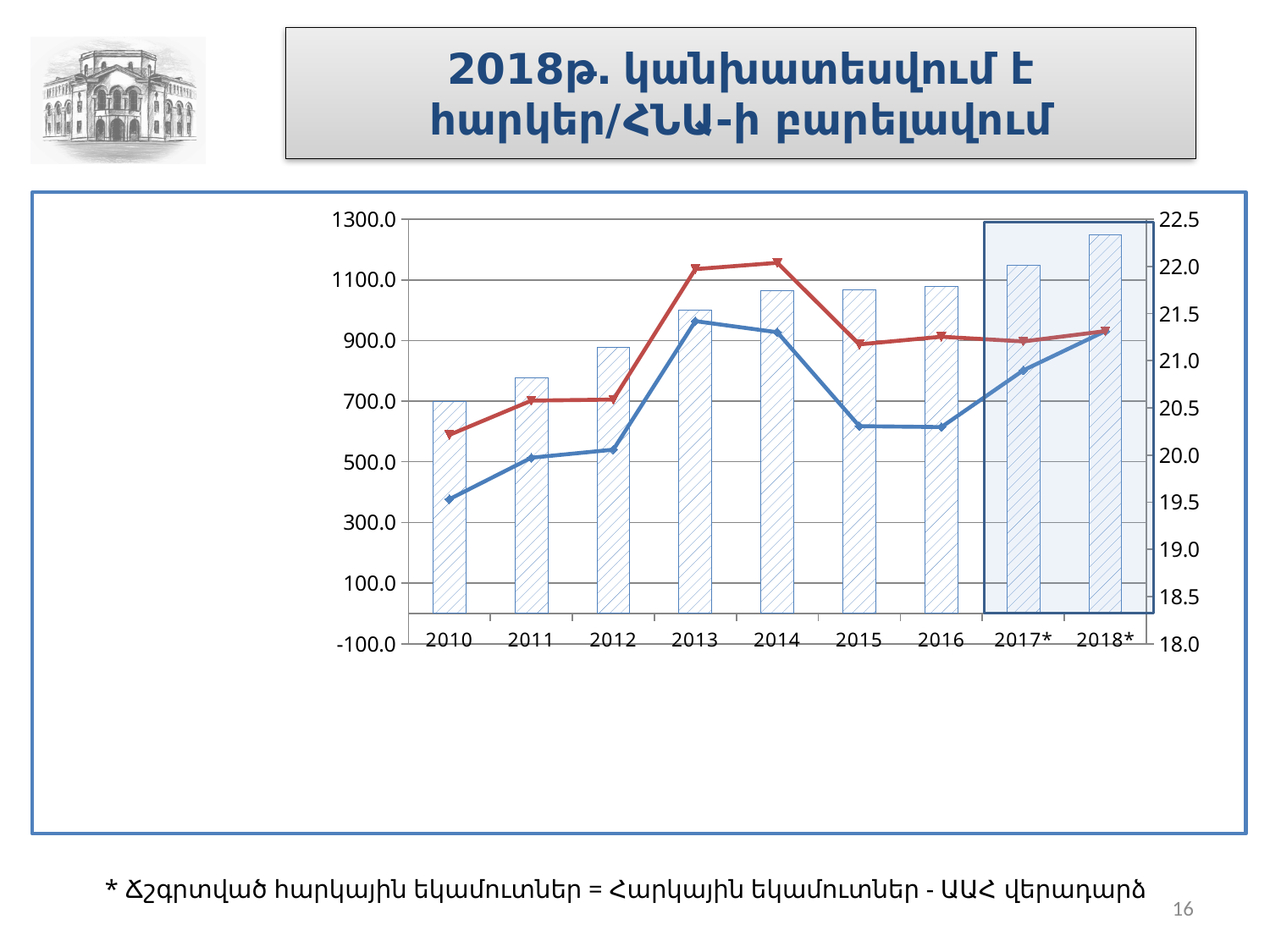
In which year is the red line at its lowest point? 2010 Which year has the tallest bar in the chart? 2018* Which years are enclosed in the highlighted box on the right side of the chart? 2017* and 2018* Which bar is taller, 2010 or 2018*? 2018* Is the blue line's value for 2010 greater or less than 20.0 on the right axis? less Is the bar for 2011 greater or less than 900.0 on the left axis? less How many years are shown along the x axis of the chart? 9 What kind of chart is shown on the slide? A combined bar and line chart Is the bar for 2013 greater or less than 900.0 on the left axis? greater Which year has the shortest bar in the chart? 2010 Do the bars generally rise or fall from 2010 to 2018*? rise